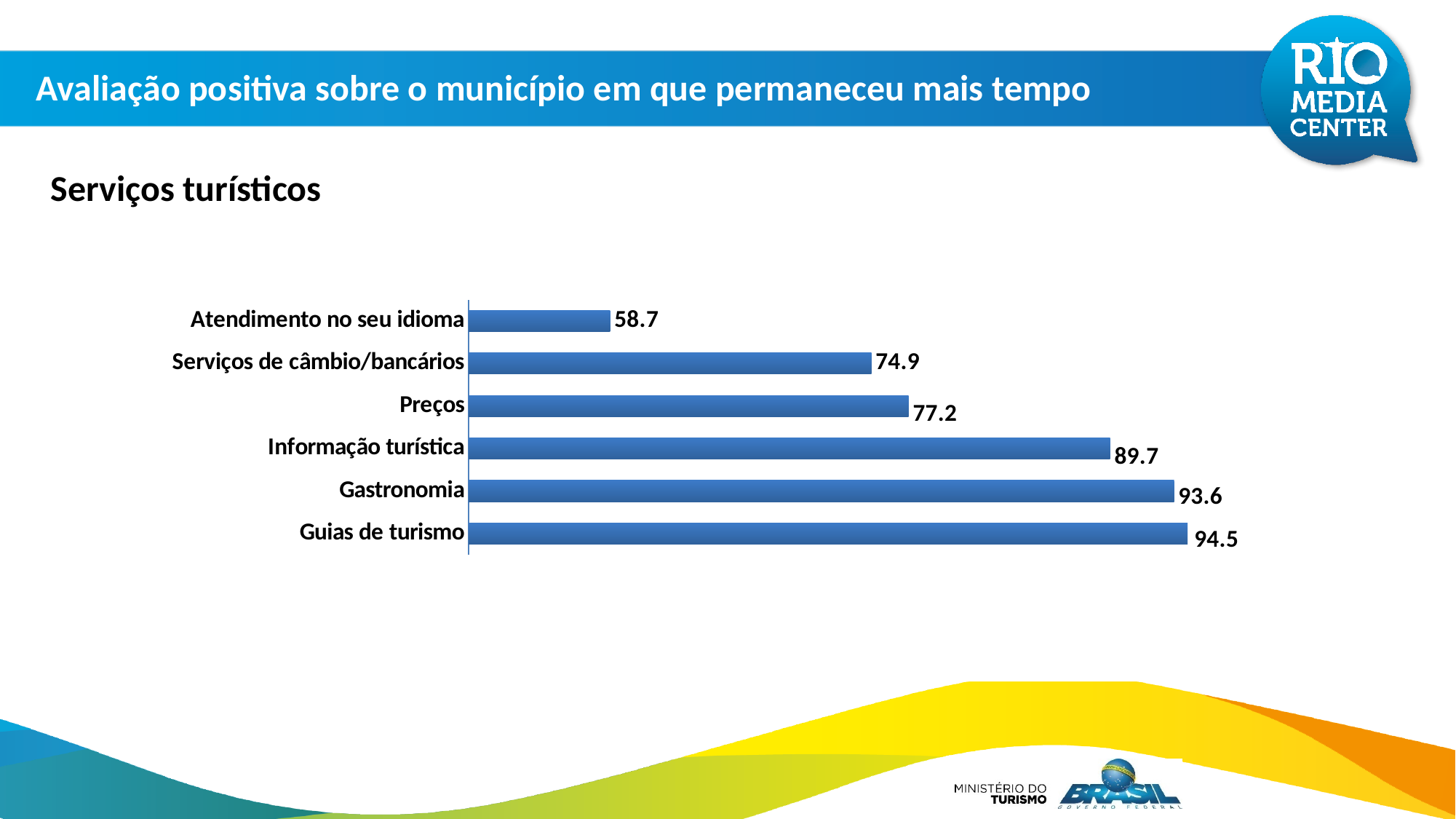
What is the value for Informação turística? 89.7 What is the value for Guias de turismo? 94.5 Which is larger, the value for Preços or the value for Serviços de câmbio/bancários? Preços What is the difference between the values for Guias de turismo and Atendimento no seu idioma? 35.8 Which category has the highest value? Guias de turismo What is the difference between the values for Gastronomia and Serviços de câmbio/bancários? 18.7 What is the value for Atendimento no seu idioma? 58.7 How many categories are shown in the chart? 6 Which category has the lowest value? Atendimento no seu idioma What kind of chart is shown on the slide? Bar chart What is the title shown above the chart? Serviços turísticos What is the value for Preços? 77.2